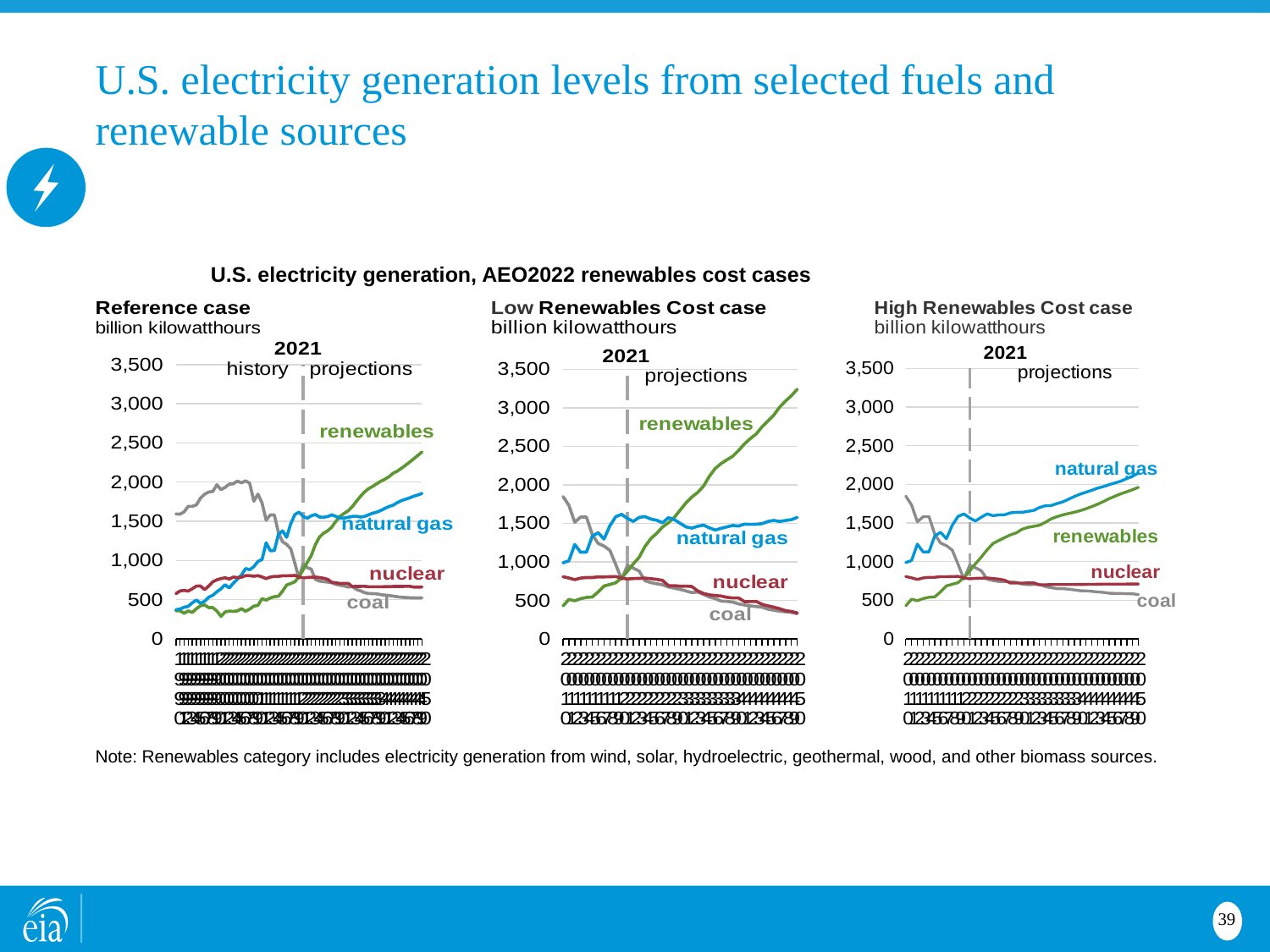
In the Reference case chart, which is larger at the end of the projection period, natural gas or nuclear? natural gas In the Low Renewables Cost case chart, is the value for renewables at the end of the projection period greater or less than 3,000? greater In the Reference case chart, is the value for coal at the end of the projection period greater or less than 1,000? less In the High Renewables Cost case chart, which series is highest at the end of the projection period? natural gas In the Low Renewables Cost case chart, is the value for natural gas at the end of the projection period greater or less than 2,000? less In the Reference case chart, which series is highest at the end of the projection period? renewables In the Reference case chart, does coal rise or fall over the projection period? fall What unit is used on the y axis of the three charts? billion kilowatthours How many series are labelled on the Reference case chart? 4 Which year does the vertical dashed line mark on each chart? 2021 What kind of chart is the Reference case chart? line chart In the Low Renewables Cost case chart, does renewables rise or fall over the projection period? rise